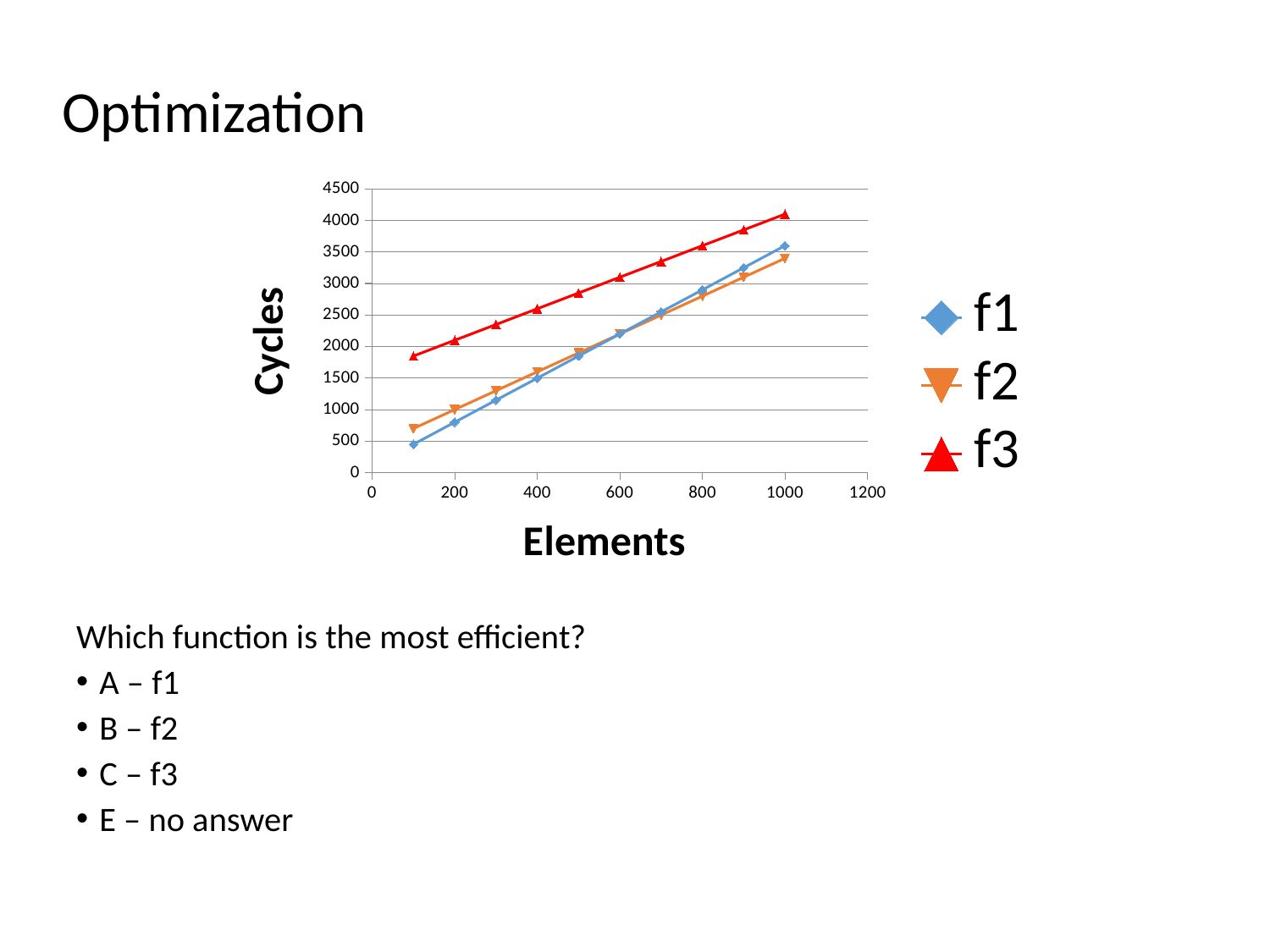
Is the Cycles value for f1 at 400 Elements greater or less than 2000? less Which series has the lowest Cycles value at 100 Elements? f1 Is the Cycles value for f3 at 500 Elements greater or less than 2500? greater What is the title of the vertical axis? Cycles Which series has the highest Cycles value at 1000 Elements? f3 How many series does the legend list? 3 Is the Cycles value for f3 at 100 Elements greater or less than 1500? greater At 100 Elements, which series has the larger Cycles value, f1 or f2? f2 What kind of chart is shown on the slide? line chart How many data points are plotted for the f3 series? 10 Do the Cycles values for f1 rise or fall as Elements increase? rise